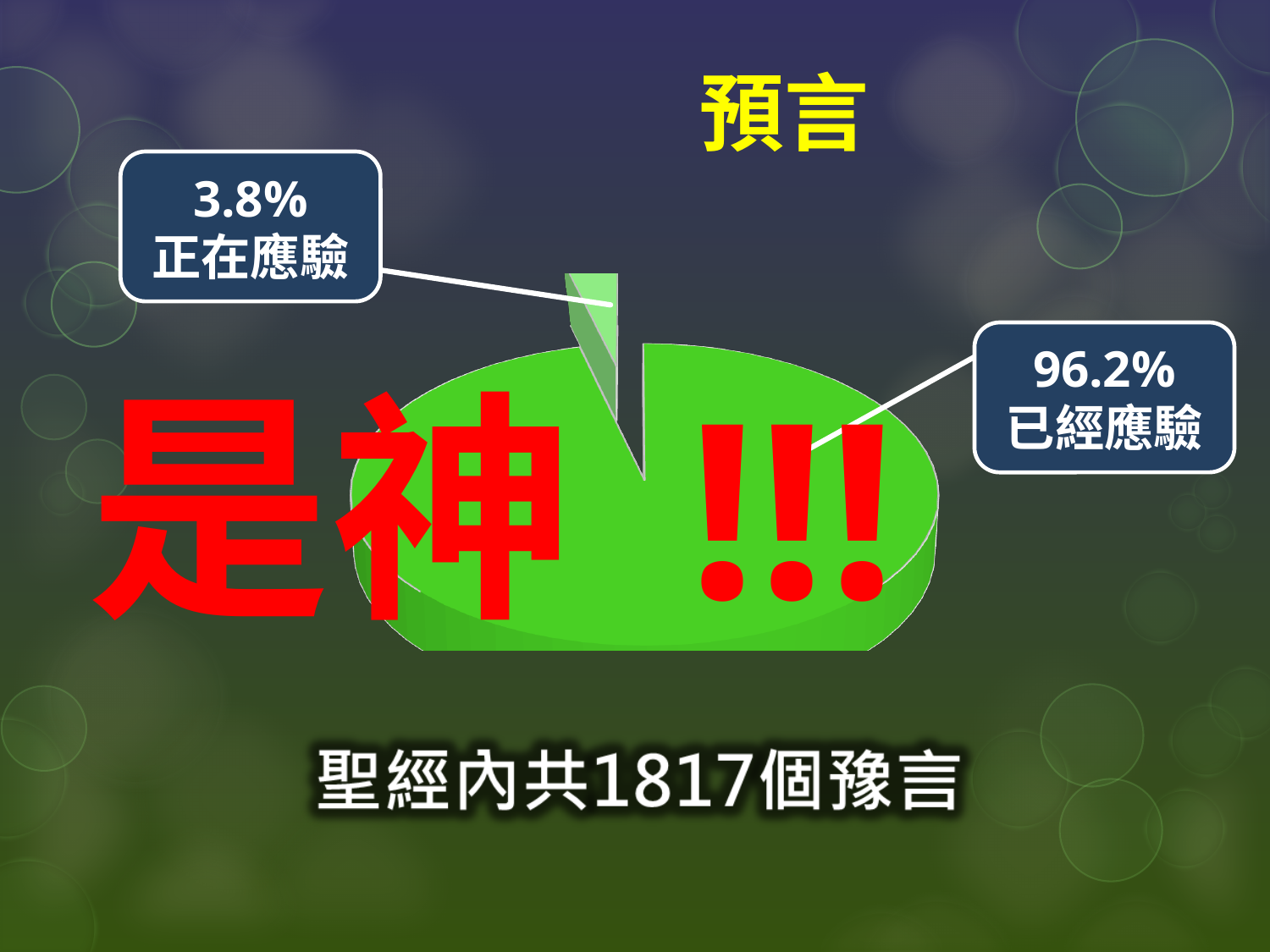
What share of the pie is labelled 正在應驗? 3.8% According to the text below the chart, how many prophecies are in the Bible in total? 1817 Which slice of the pie is the smallest? 正在應驗 What is the difference in percentage points between the 已經應驗 slice and the 正在應驗 slice? 92.4 Which is larger, the 正在應驗 slice or the 已經應驗 slice? 已經應驗 How many slices does the pie chart have? 2 What is the title shown above the pie chart? 預言 Which slice of the pie is the largest? 已經應驗 What kind of chart is shown on the slide? pie chart What share of the pie is labelled 已經應驗? 96.2%